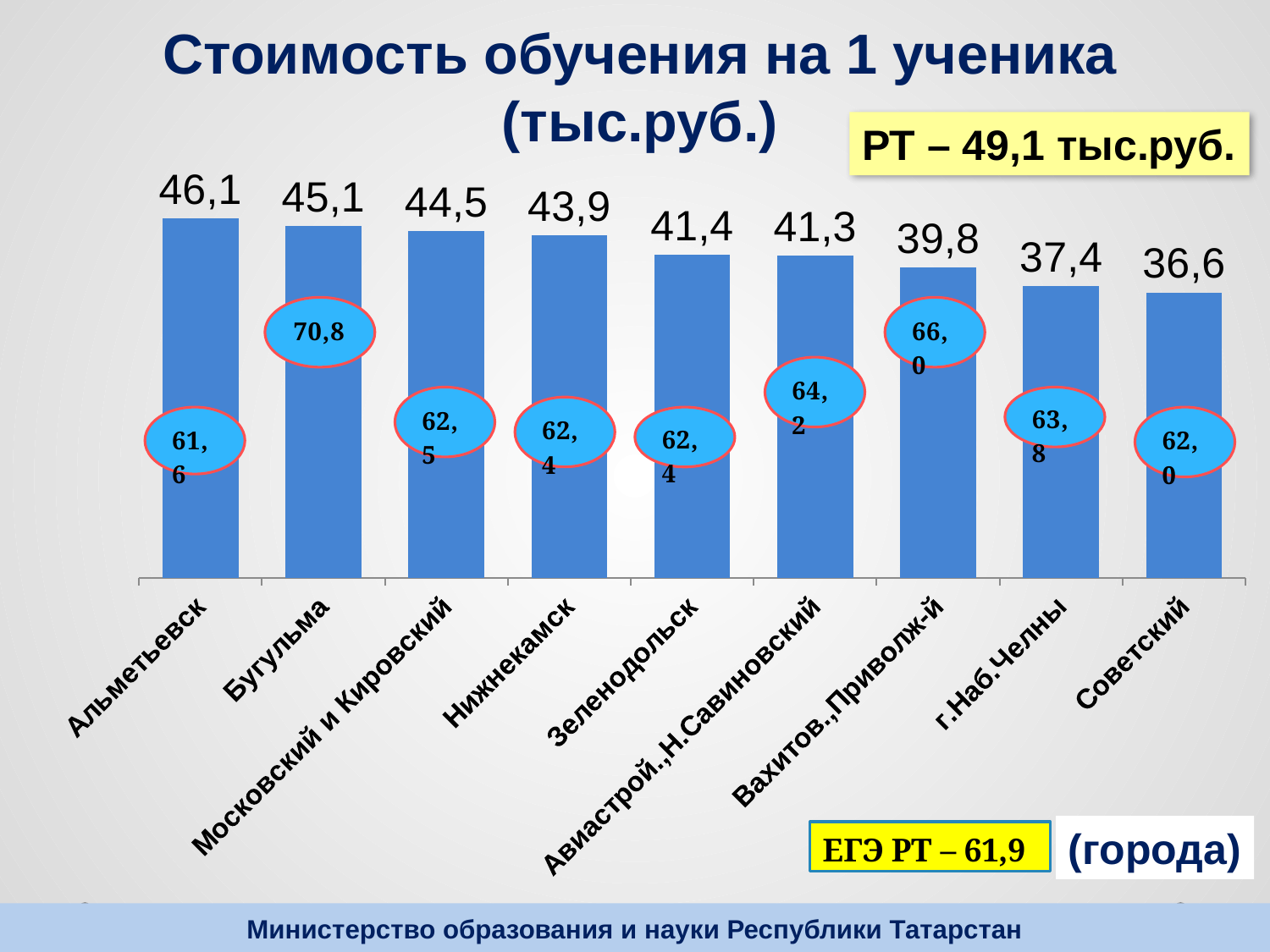
Do the bar values rise or fall from left to right along the x axis? fall Which category has the highest value? Альметьевск What is the value for Альметьевск? 46,1 What is the difference between the values for Бугульма and Нижнекамск? 1,2 What is the value for Нижнекамск? 43,9 How many categories are shown on the chart? 9 What is the value for Вахитов.,Приволж-й? 39,8 Which is larger, the value for Московский и Кировский or the value for Зеленодольск? Московский и Кировский Which category has the lowest value? Советский What is the difference between the values for Альметьевск and Советский? 9,5 What kind of chart is shown on the slide? bar chart What is the value for г.Наб.Челны? 37,4